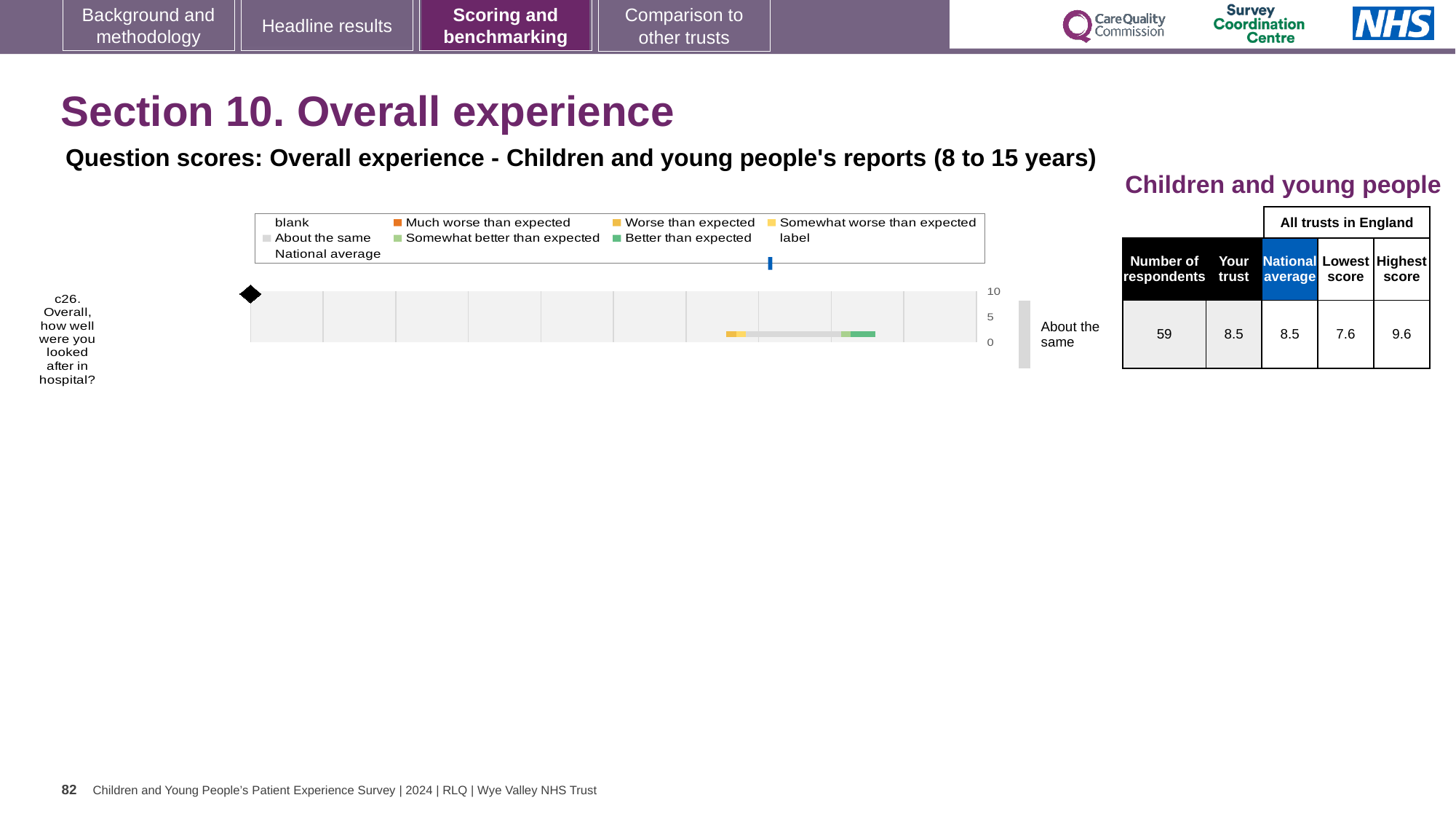
What kind of chart is used to show the score for question c26? bar chart What benchmark category label is shown next to the bar for c26? About the same What is the national average score for c26? 8.5 What is the difference between the highest and lowest scores for c26? 2.0 What is the lowest score among all trusts in England for c26? 7.6 Is the trust's score for c26 higher than, lower than, or the same as the national average? the same What is the highest score among all trusts in England for c26? 9.6 Which legend entry is shown with the orange colour? Much worse than expected How much higher is the trust's score for c26 than the lowest score in England? 0.9 How many questions are plotted in the chart? 1 What is the 'Your trust' score for c26 (Overall, how well were you looked after in hospital?)? 8.5 How many respondents answered question c26? 59